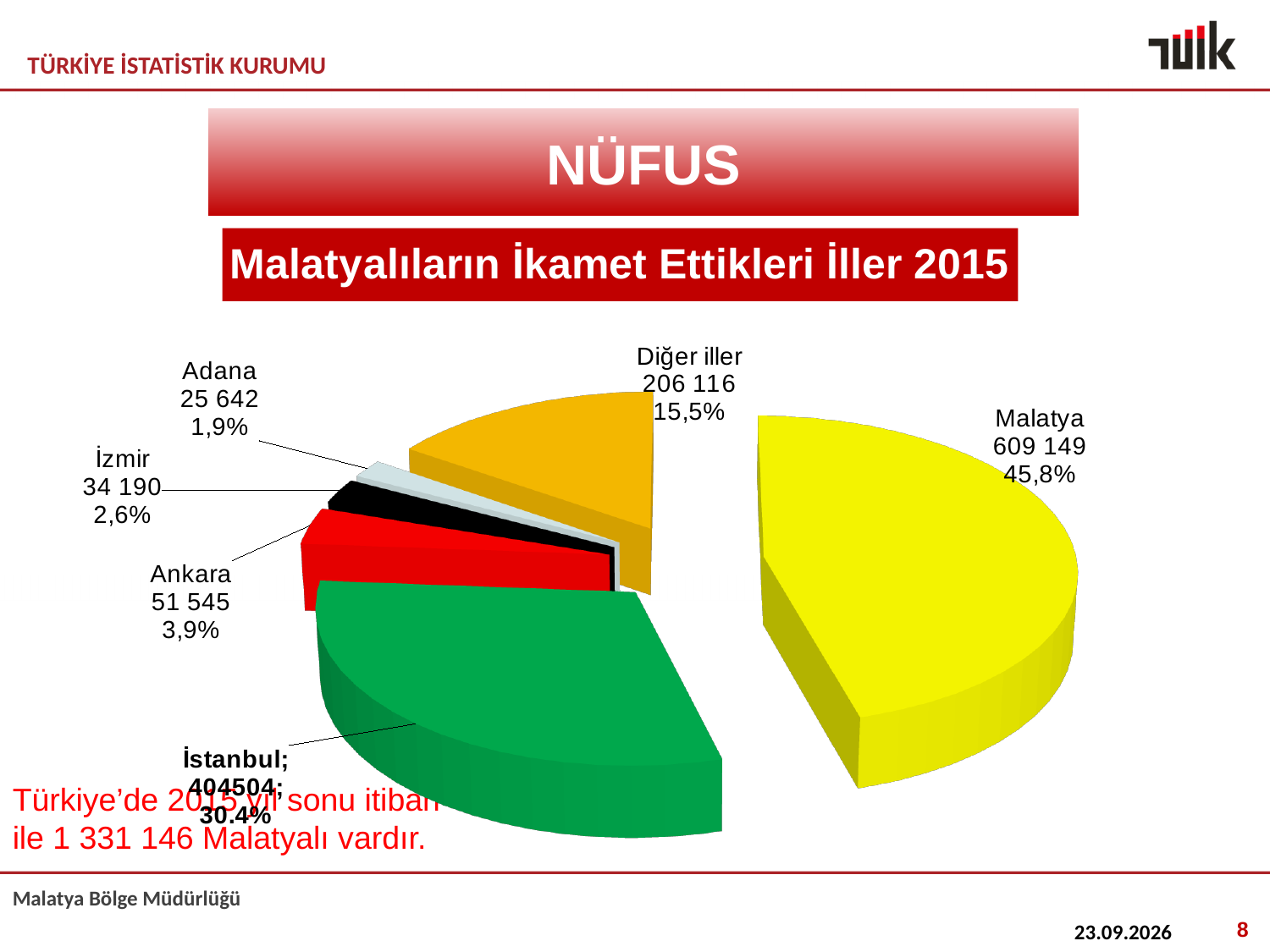
What is the difference between the values for İzmir and Adana? 8 548 Which is larger, the value for Ankara or the value for İzmir? Ankara What kind of chart is shown on the slide? Pie chart What percentage is shown for İzmir? 2,6% What is the value shown for Diğer iller? 206 116 What is the title of the chart? Malatyalıların İkamet Ettikleri İller 2015 How many slices does the pie chart have? 6 What is the population value shown for Malatya? 609 149 Which province has the largest slice of the pie? Malatya What percentage share does the Malatya slice have? 45,8% What is the value shown for Ankara? 51 545 Which labelled category has the smallest slice of the pie? Adana